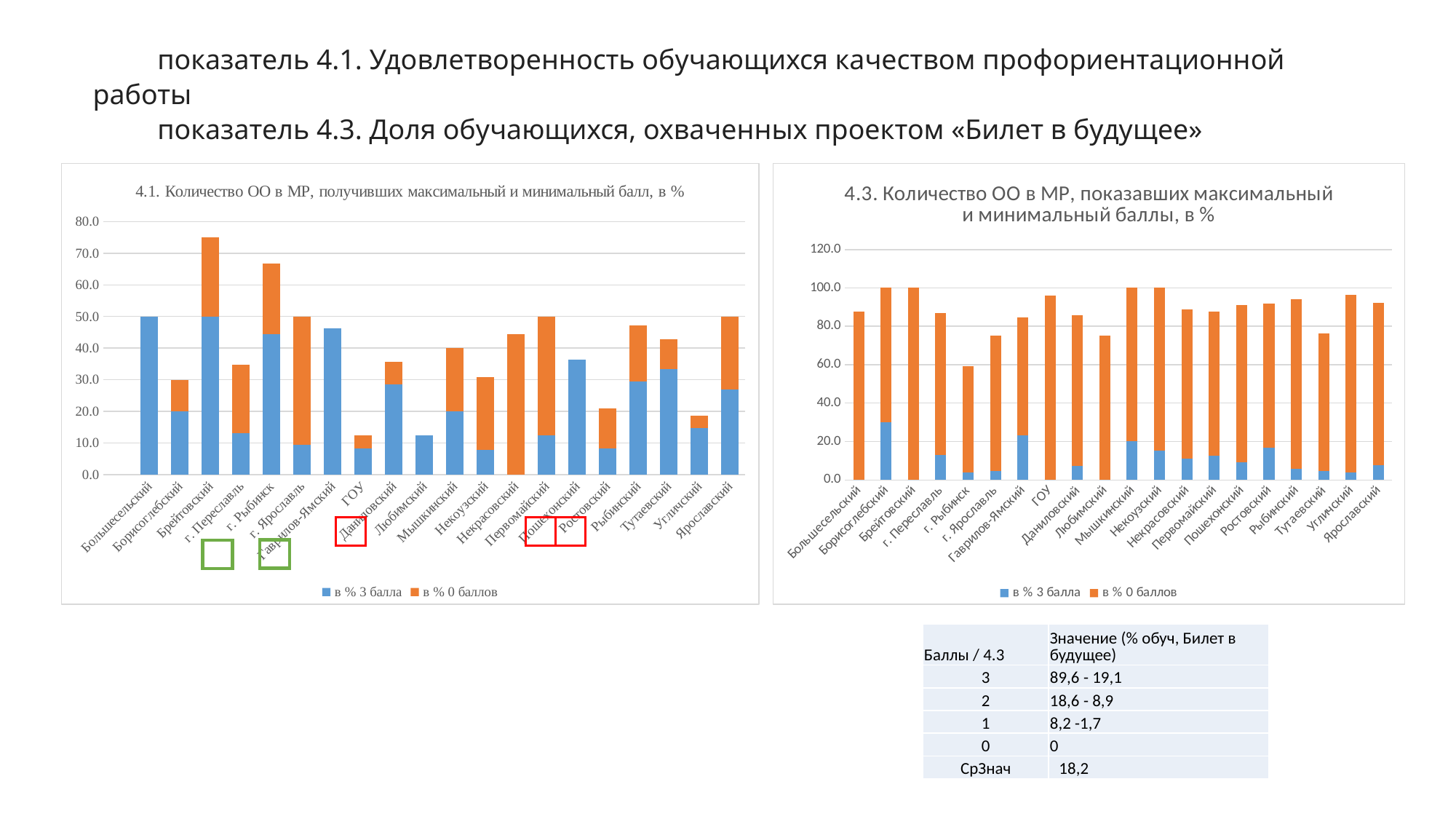
What are the two legend entries of the left chart (4.1)? в % 3 балла and в % 0 баллов In the right chart (4.3), is the total stacked value for г. Рыбинск greater or less than 80? less What kind of chart is the left chart titled "4.1. Количество ОО в МР, получивших максимальный и минимальный балл, в %"? Stacked bar chart In the left chart (4.1), is the total stacked value for Брейтовский greater or less than 70? greater In the left chart (4.1), which category has the tallest stacked bar? Брейтовский In the left chart (4.1), is the total stacked value for ГОУ greater or less than 20? less In the right chart (4.3), which has the larger total stacked value: Брейтовский or г. Рыбинск? Брейтовский In the right chart (4.3), which category has the shortest stacked bar? г. Рыбинск How many categories are shown on the x axis of the left chart (4.1)? 20 How many series does the legend of the right chart (4.3) list? 2